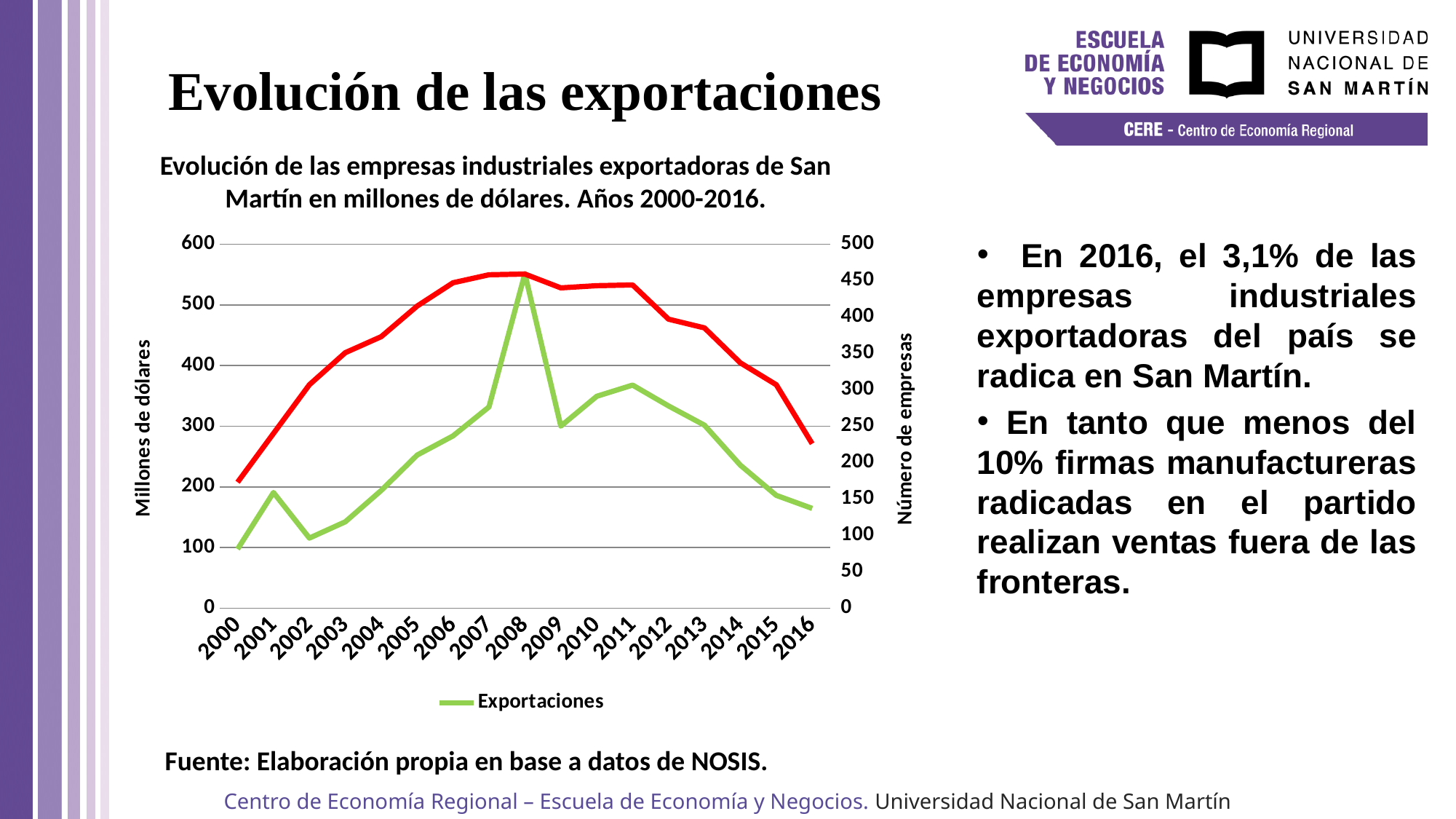
In which year does the Exportaciones line have its lowest value? 2000 What kind of chart is shown on the slide? Line chart Which year has the larger Exportaciones value, 2011 or 2013? 2011 Is the Exportaciones value for 2008 greater or less than 500 on the left axis? greater What is the title of the left vertical axis of the chart? Millones de dólares Is the Exportaciones value for 2016 greater or less than 200 on the left axis? less Does the Exportaciones line rise or fall from 2008 to 2009? Falls Is the Exportaciones value for 2000 greater or less than 200 on the left axis? less How many years are plotted along the x axis of the chart? 17 In which year does the Exportaciones line reach its highest value? 2008 Which year has the larger Exportaciones value, 2001 or 2002? 2001 How many series does the chart's legend list? 1